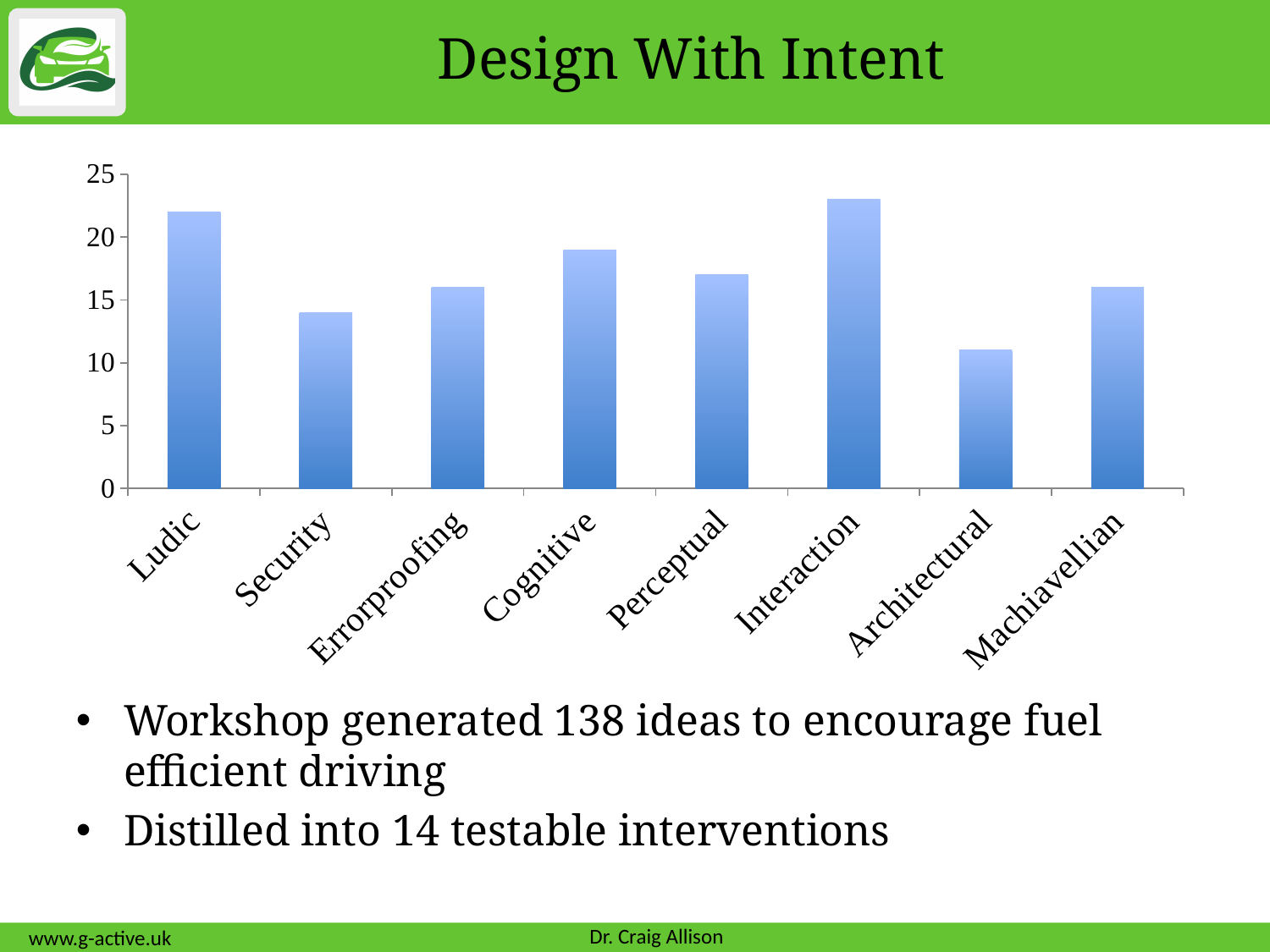
What is the highest value shown on the vertical axis of the chart? 25 Is the value for Cognitive greater or less than 20? less Which is larger, the value for Cognitive or the value for Security? Cognitive Is the value for Ludic greater or less than 20? greater Which is larger, the value for Perceptual or the value for Architectural? Perceptual What kind of chart is shown on the slide? bar chart Which category has the lowest bar? Architectural Is the value for Perceptual greater or less than 15? greater Which category has the highest bar? Interaction How many categories are plotted on the chart? 8